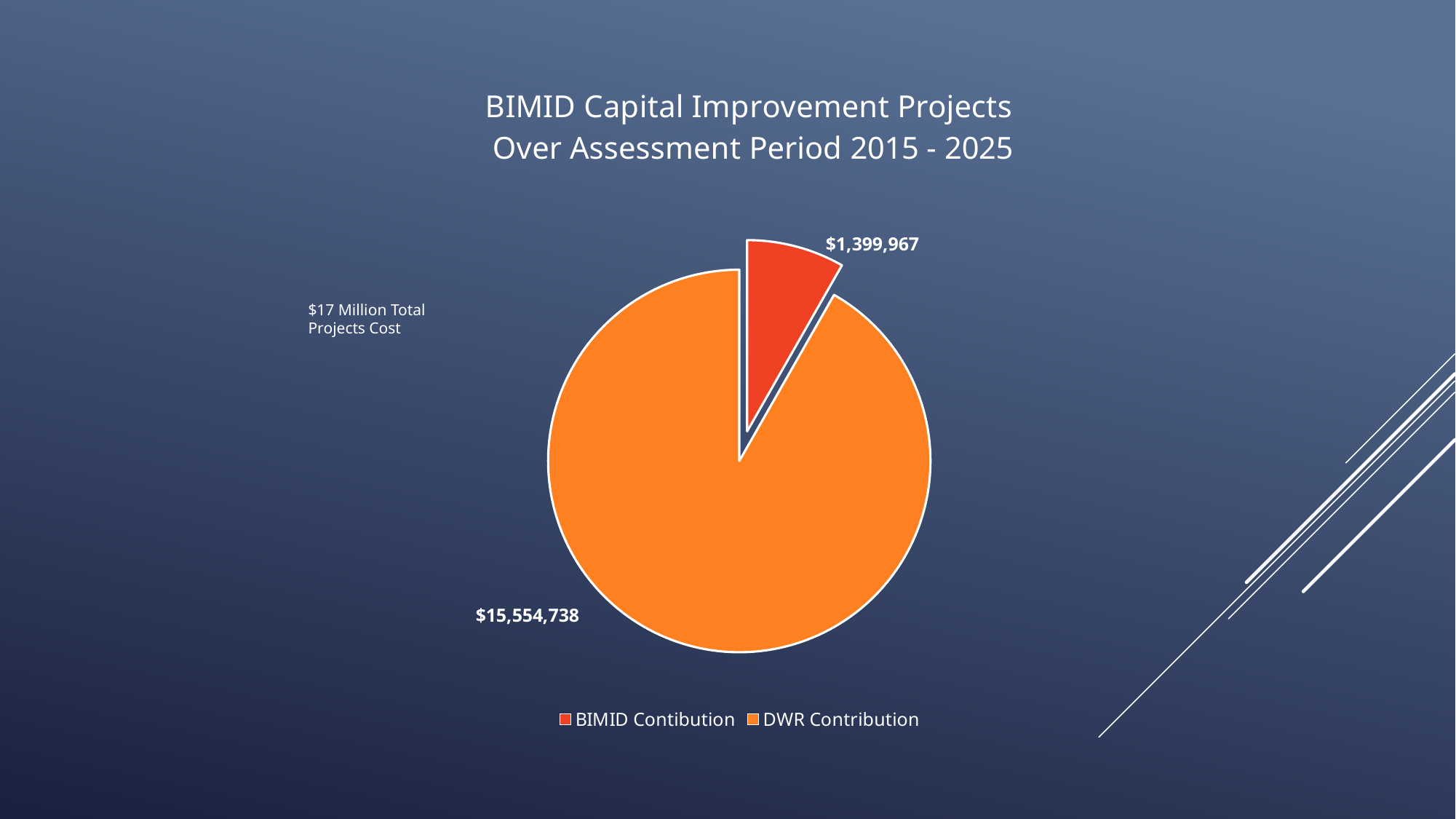
What type of chart is shown on the slide? Pie chart What is the value of the DWR Contribution slice? $15,554,738 What is the difference between the DWR Contribution and the BIMID Contribution? $14,154,771 Which slice of the pie is the largest? DWR Contribution How many slices does the pie chart have? 2 What is the value of the BIMID Contribution slice? $1,399,967 What colour is the DWR Contribution slice? Orange What is the title of the chart? BIMID Capital Improvement Projects Over Assessment Period 2015 - 2025 Which slice of the pie is the smallest? BIMID Contribution What is the combined total of the two slices shown on the pie? $16,954,705 Which is larger, the BIMID Contribution or the DWR Contribution? DWR Contribution How many entries does the legend list? 2